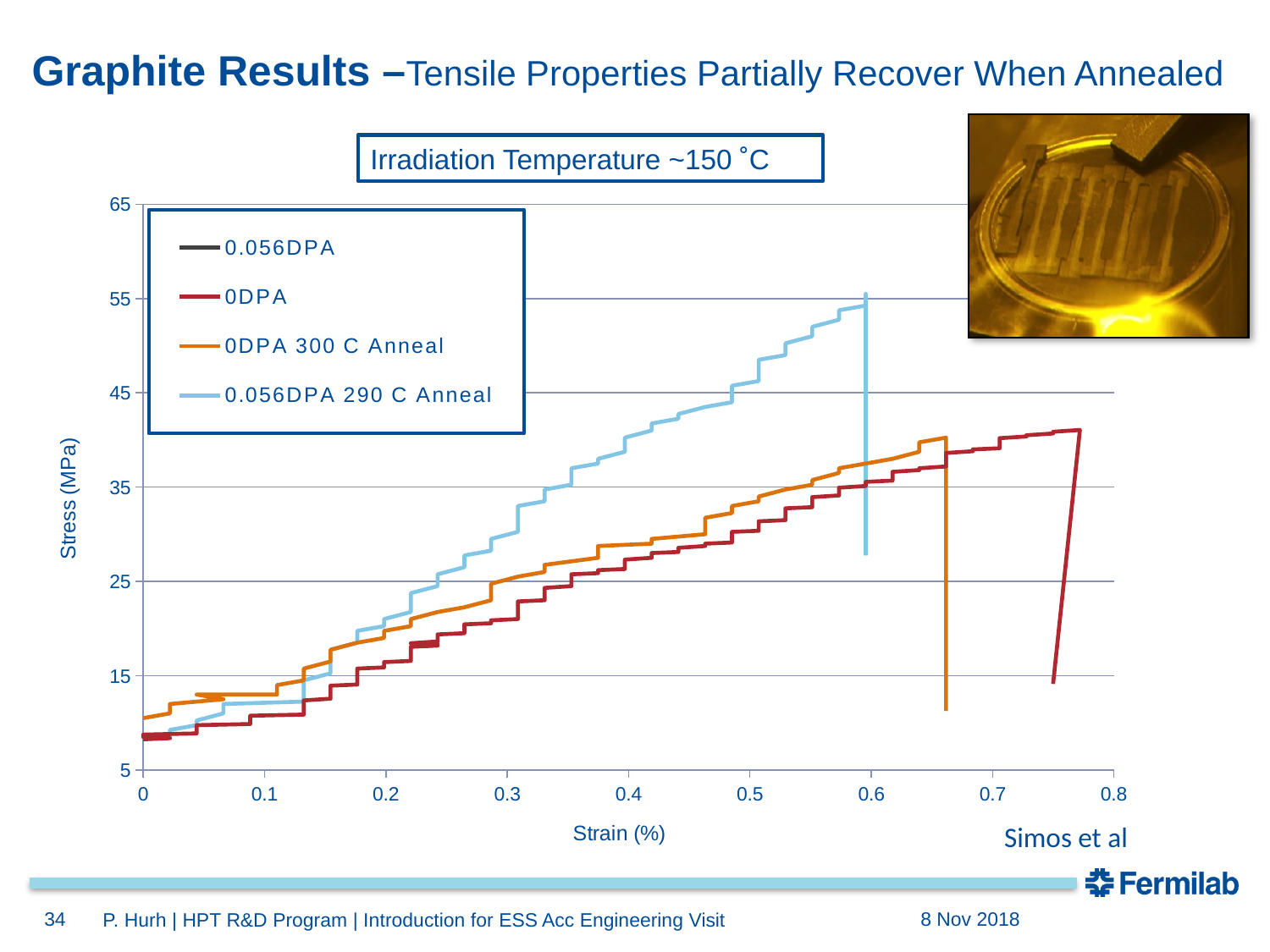
Which series extends to the largest strain before failing? 0DPA What kind of chart is shown on the slide? Line chart How many series does the chart legend list? 4 Is the peak stress of the 0DPA series greater or less than 45 MPa? less Is the strain at which the 0.056DPA 290 C Anneal series fails greater or less than 0.5%? greater Is the strain at which the 0DPA series fails greater or less than 0.7%? greater What is the label of the vertical axis of the chart? Stress (MPa) Does stress rise or fall as strain increases along each curve before failure? Rise Which series reaches a higher peak stress, 0DPA or 0.056DPA 290 C Anneal? 0.056DPA 290 C Anneal Which series reaches the highest stress on the chart? 0.056DPA 290 C Anneal